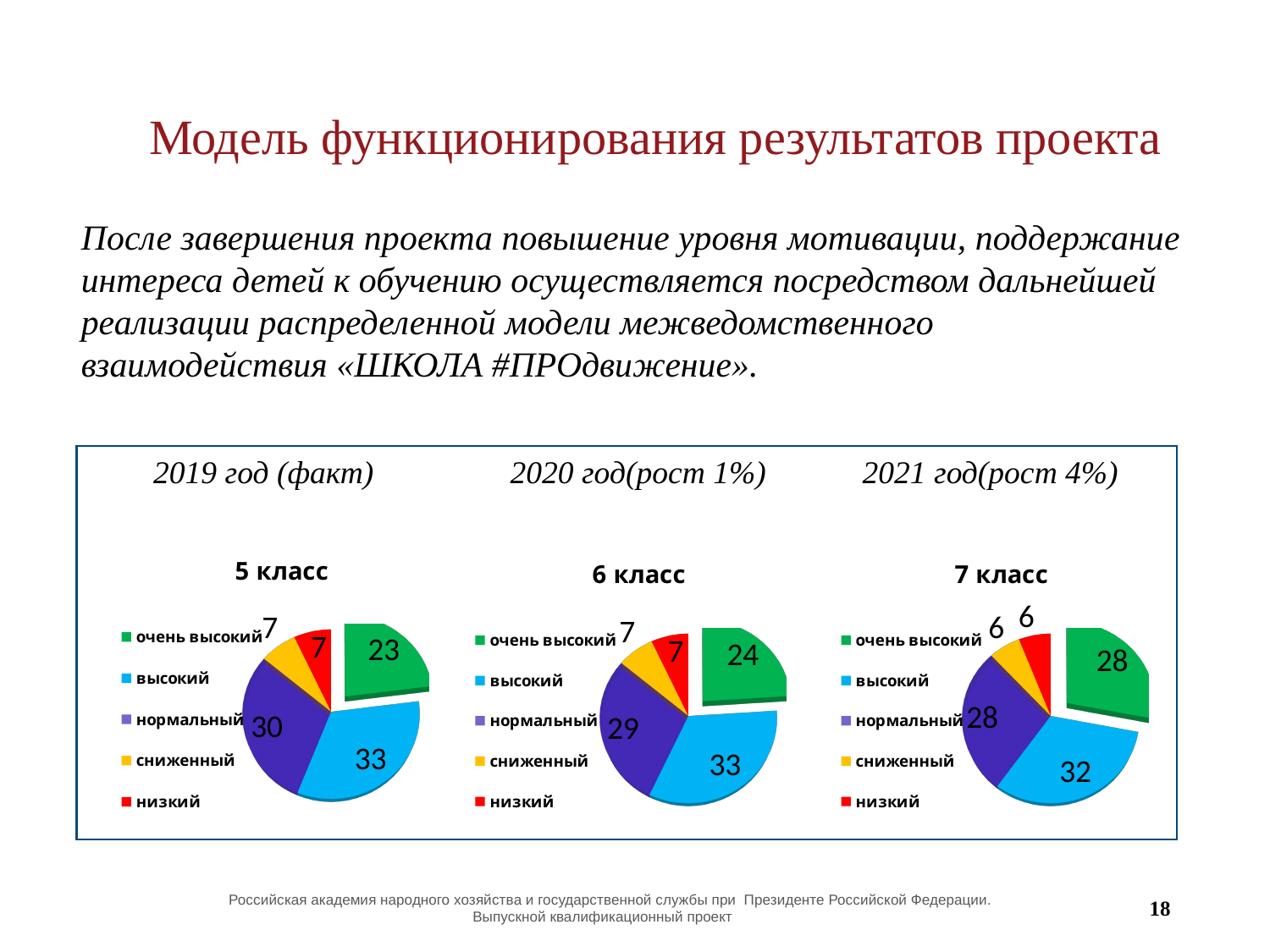
In the "7 класс" pie chart, what is the value for "нормальный"? 28 In the "6 класс" pie chart, which is larger: the value for "очень высокий" or the value for "нормальный"? нормальный In the "6 класс" pie chart, what is the value for "очень высокий"? 24 In the "5 класс" pie chart, what is the difference between the values for "высокий" and "нормальный"? 3 In the "7 класс" pie chart, which category has the largest slice? высокий In the "5 класс" pie chart, what is the value for "высокий"? 33 In the "6 класс" pie chart, what is the difference between the values for "очень высокий" and "сниженный"? 17 What type of chart is the "5 класс" chart? pie chart How many slices does the "7 класс" pie chart have? 5 Which colour represents "сниженный" in the pie charts? yellow In the "7 класс" pie chart, what is the value for "низкий"? 6 In the "5 класс" pie chart, which category has the largest slice? высокий